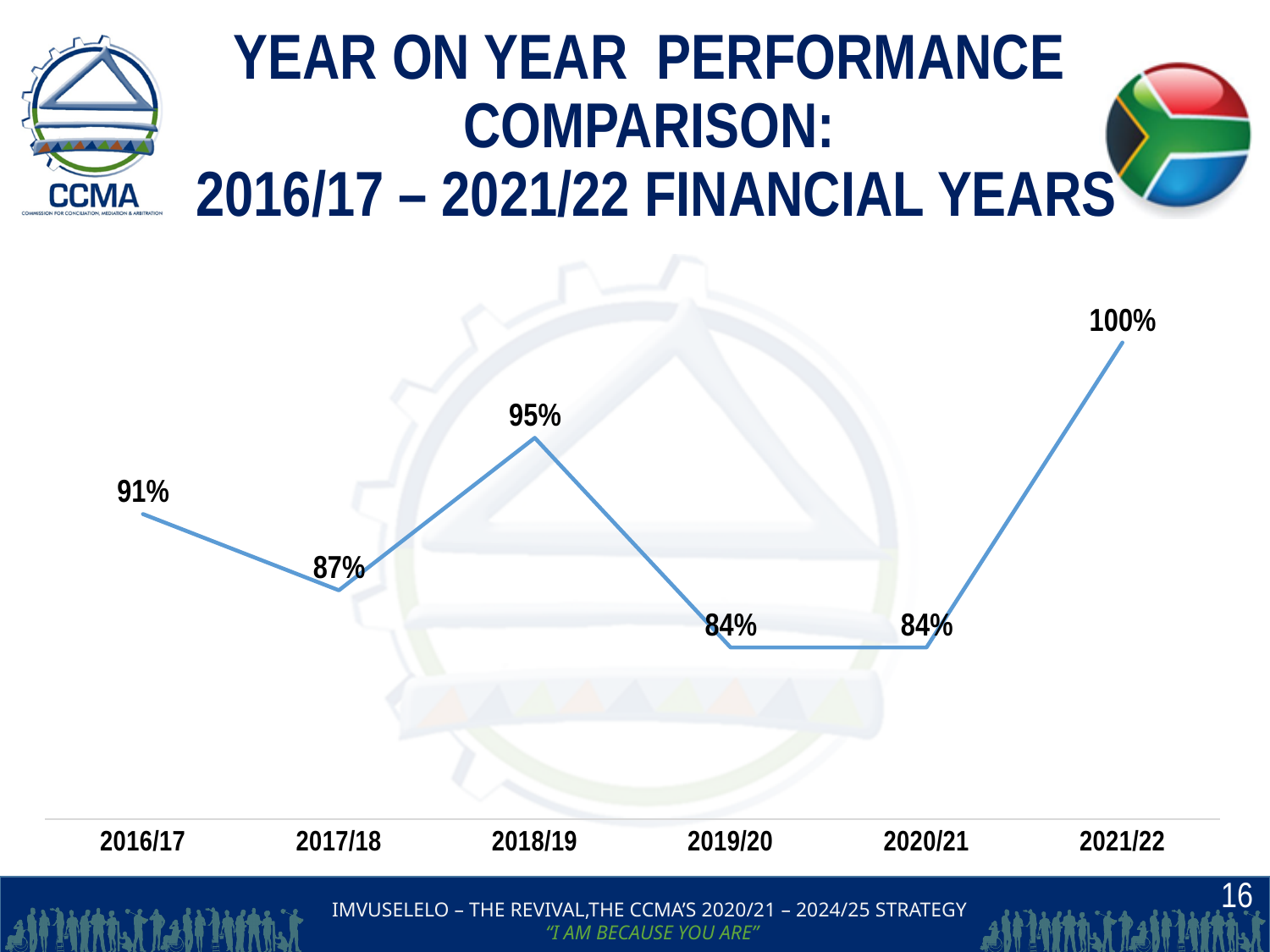
What is the difference between the values for 2018/19 and 2017/18? 8% What is the value for 2021/22? 100% Which is larger, the value for 2016/17 or the value for 2017/18? 2016/17 What is the lowest value shown on the chart? 84% What is the value for 2018/19? 95% Which financial year has the highest value? 2021/22 What is the difference between the values for 2021/22 and 2020/21? 16% What is the value for 2020/21? 84% Does the value rise or fall from 2018/19 to 2019/20? Fall How many financial years are plotted on the chart? 6 What kind of chart is shown on the slide? Line chart What is the value for 2016/17? 91%